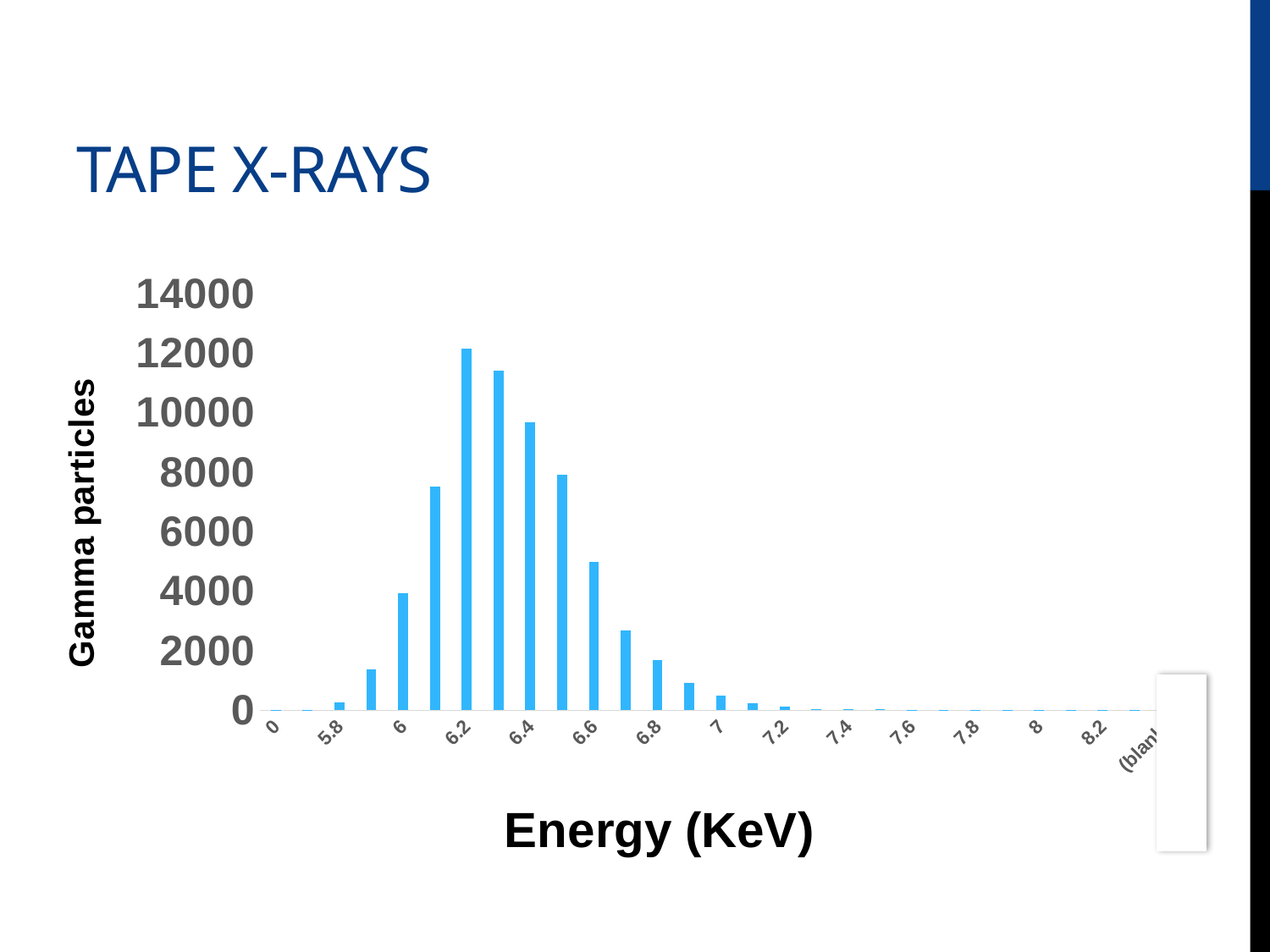
Which has more gamma particles, 6.2 KeV or 6.6 KeV? 6.2 KeV What kind of chart is shown on the slide? bar chart Is the value for 7 KeV greater or less than 2000? less What is the title of the y axis? Gamma particles Is the value for 6.4 KeV greater or less than 10000? less At which labelled energy value is the number of gamma particles highest? 6.2 Do the values rise or fall along the x axis from 6.2 KeV to 7 KeV? fall Is the value for 6.6 KeV greater or less than 4000? greater What is the title of the x axis? Energy (KeV) Which has more gamma particles, 6.4 KeV or 6.8 KeV? 6.4 KeV